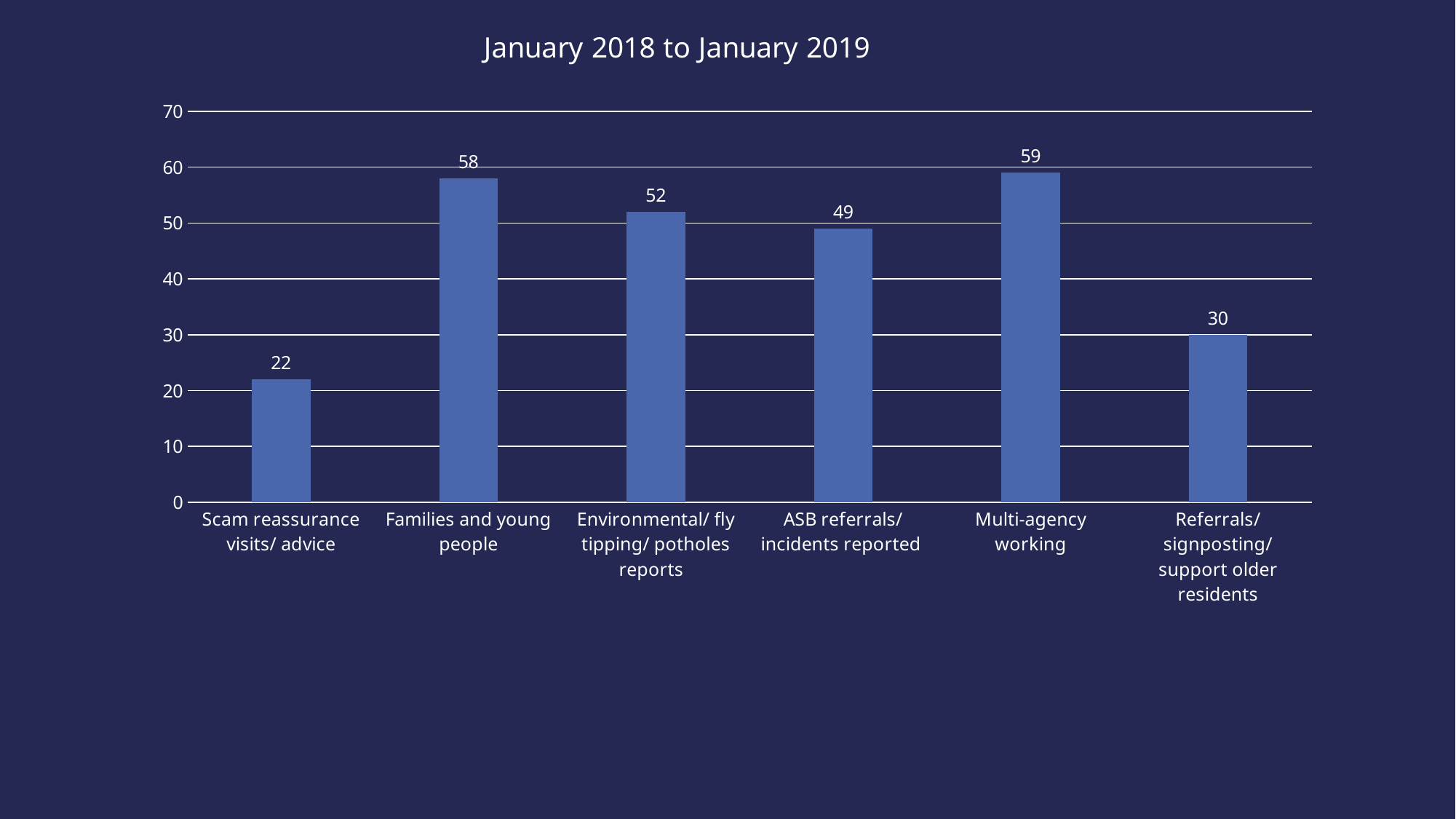
Which is larger: Environmental/ fly tipping/ potholes reports or Referrals/ signposting/ support older residents? Environmental/ fly tipping/ potholes reports Which category has the lowest value? Scam reassurance visits/ advice What is the value for Multi-agency working? 59 What is the value for Scam reassurance visits/ advice? 22 What is the title of the chart? January 2018 to January 2019 What kind of chart is shown on the slide? bar chart Which category has the highest value? Multi-agency working Is the value for ASB referrals/ incidents reported greater or less than 40? greater What is the value for ASB referrals/ incidents reported? 49 What is the value for Referrals/ signposting/ support older residents? 30 How many categories are shown on the chart? 6 What is the difference between the values for Families and young people and Scam reassurance visits/ advice? 36